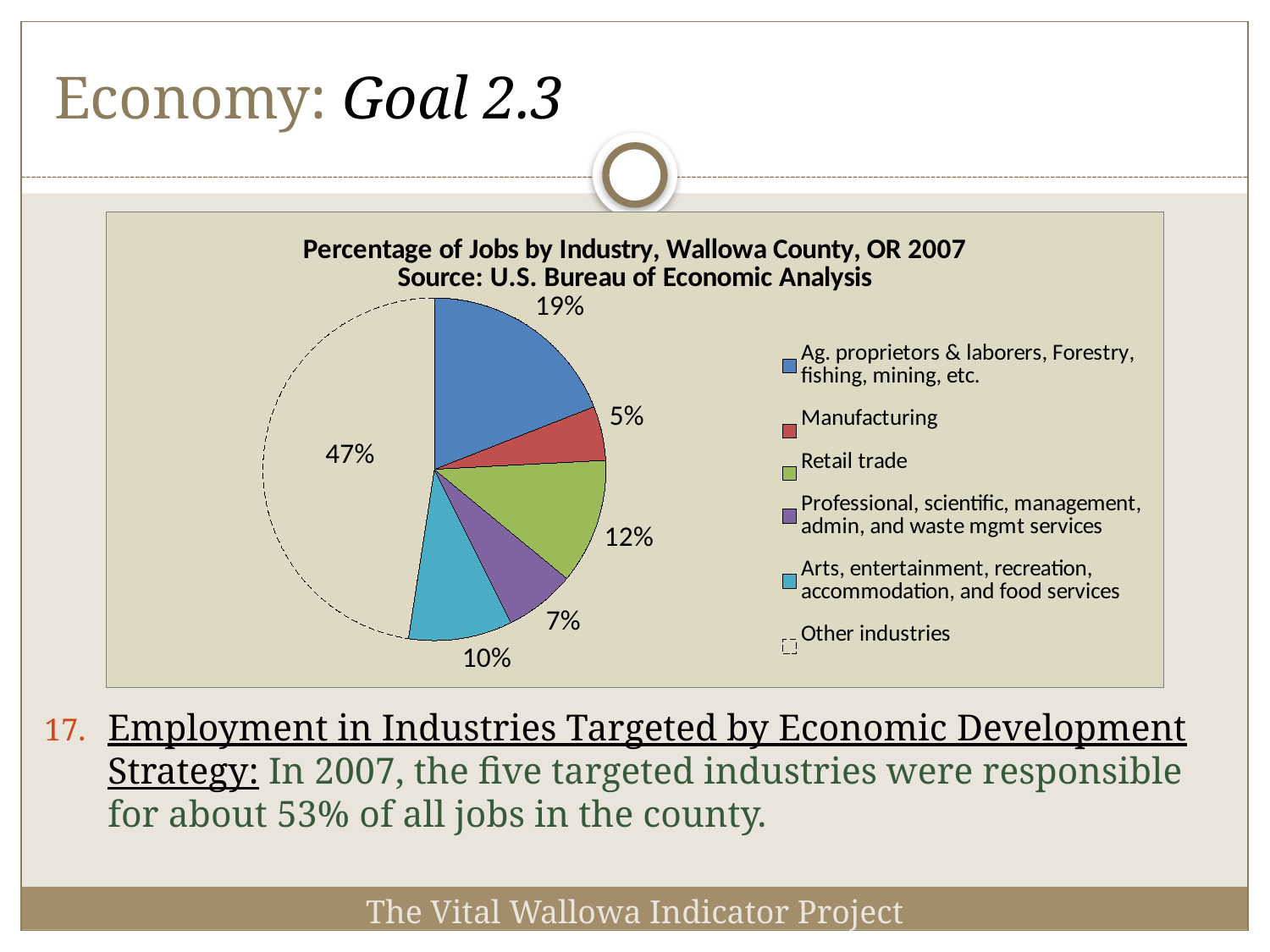
Which has a larger share of jobs: Arts, entertainment, recreation, accommodation, and food services or Professional, scientific, management, admin, and waste mgmt services? Arts, entertainment, recreation, accommodation, and food services What is the title of the chart? Percentage of Jobs by Industry, Wallowa County, OR 2007 What kind of chart is shown on the slide? pie chart What percentage of jobs is shown for Ag. proprietors & laborers, Forestry, fishing, mining, etc.? 19% What percentage of jobs is shown for Manufacturing? 5% What percentage of jobs is shown for Retail trade? 12% Which category has the largest share of the pie? Other industries Which industry category has the smallest share of jobs? Manufacturing How many categories does the legend list? 6 What source is cited in the chart title? U.S. Bureau of Economic Analysis What percentage of jobs is shown for Other industries? 47% What is the difference in percentage points between Retail trade and Manufacturing? 7